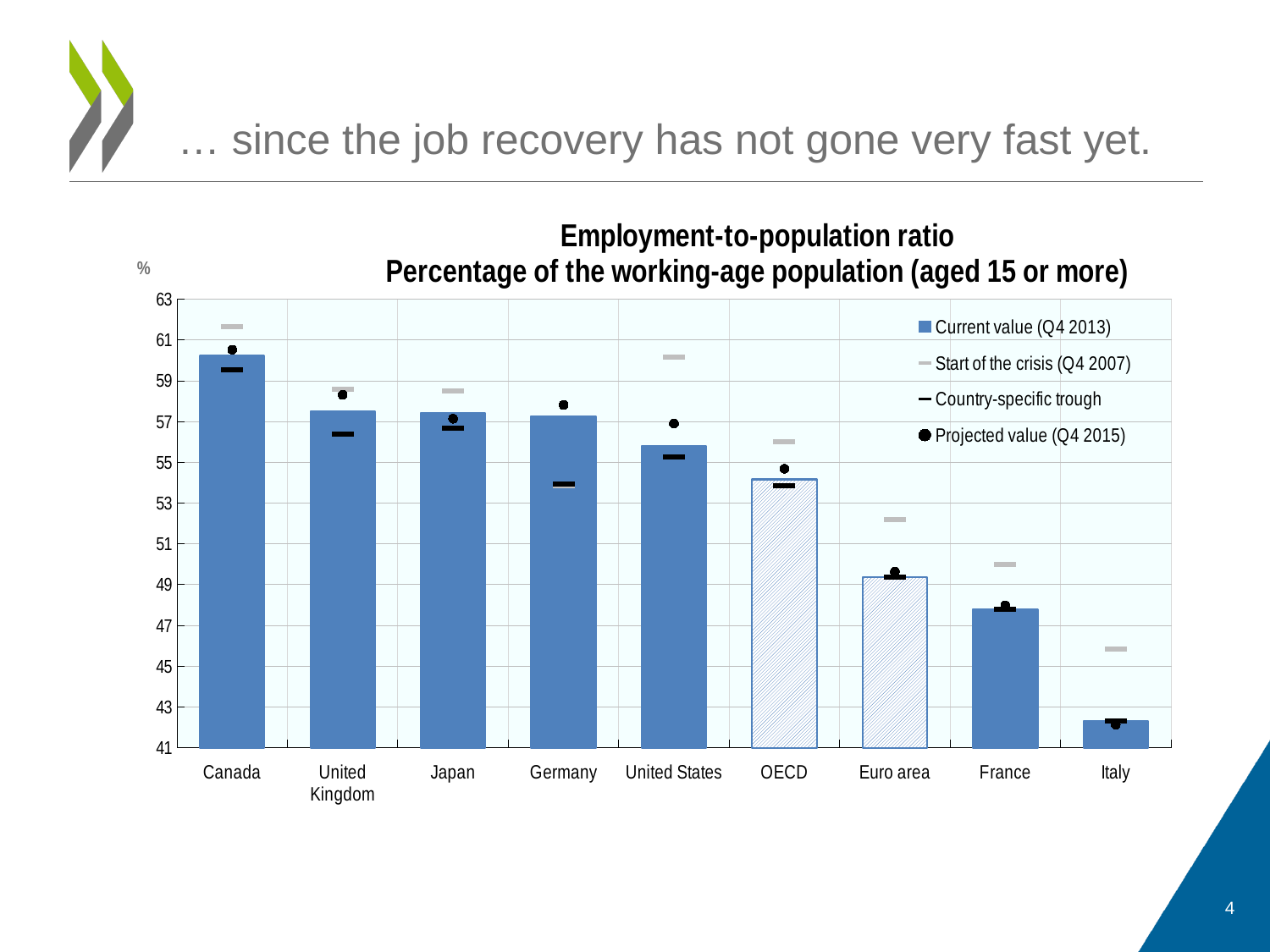
Which legend entry is represented by a black dot marker? Projected value (Q4 2015) Is the current value (Q4 2013) bar for Canada greater or less than 59? greater Which has a larger current value (Q4 2013) bar, the United States or France? United States Do the current value (Q4 2013) bars rise or fall moving from left to right along the x axis? fall How many countries or regions are shown on the x axis of the chart? 9 How many series does the chart's legend list? 4 Which country or region has the highest current value (Q4 2013) bar? Canada Is the current value (Q4 2013) bar for the OECD greater or less than 53? greater Which country or region has the lowest current value (Q4 2013) bar? Italy What kind of chart is shown on the slide? Bar chart Is the current value (Q4 2013) bar for Italy greater or less than 43? less